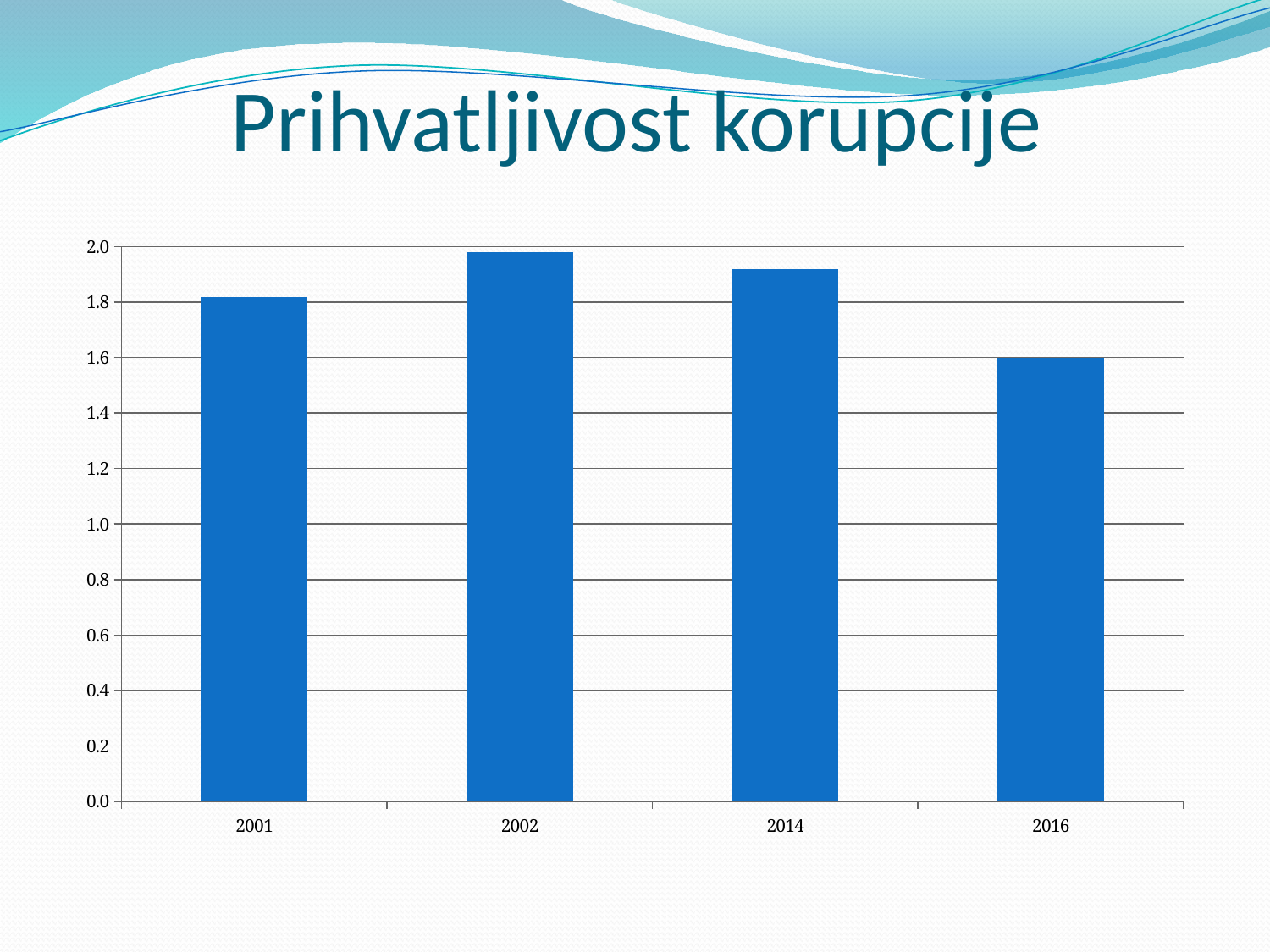
What is the highest value shown on the y axis of the chart? 2.0 Which year has the highest bar in the chart? 2002 What is the title of the chart? Prihvatljivost korupcije Which year has the lowest bar in the chart? 2016 Is the value for 2014 greater or less than 2.0? less Is the value for 2002 greater or less than 1.8? greater Which is larger, the value for 2001 or the value for 2016? 2001 Is the value for 2016 greater or less than 1.8? less What type of chart is shown on the slide? bar chart How many years are shown on the x axis of the chart? 4 Which is larger, the value for 2001 or the value for 2014? 2014